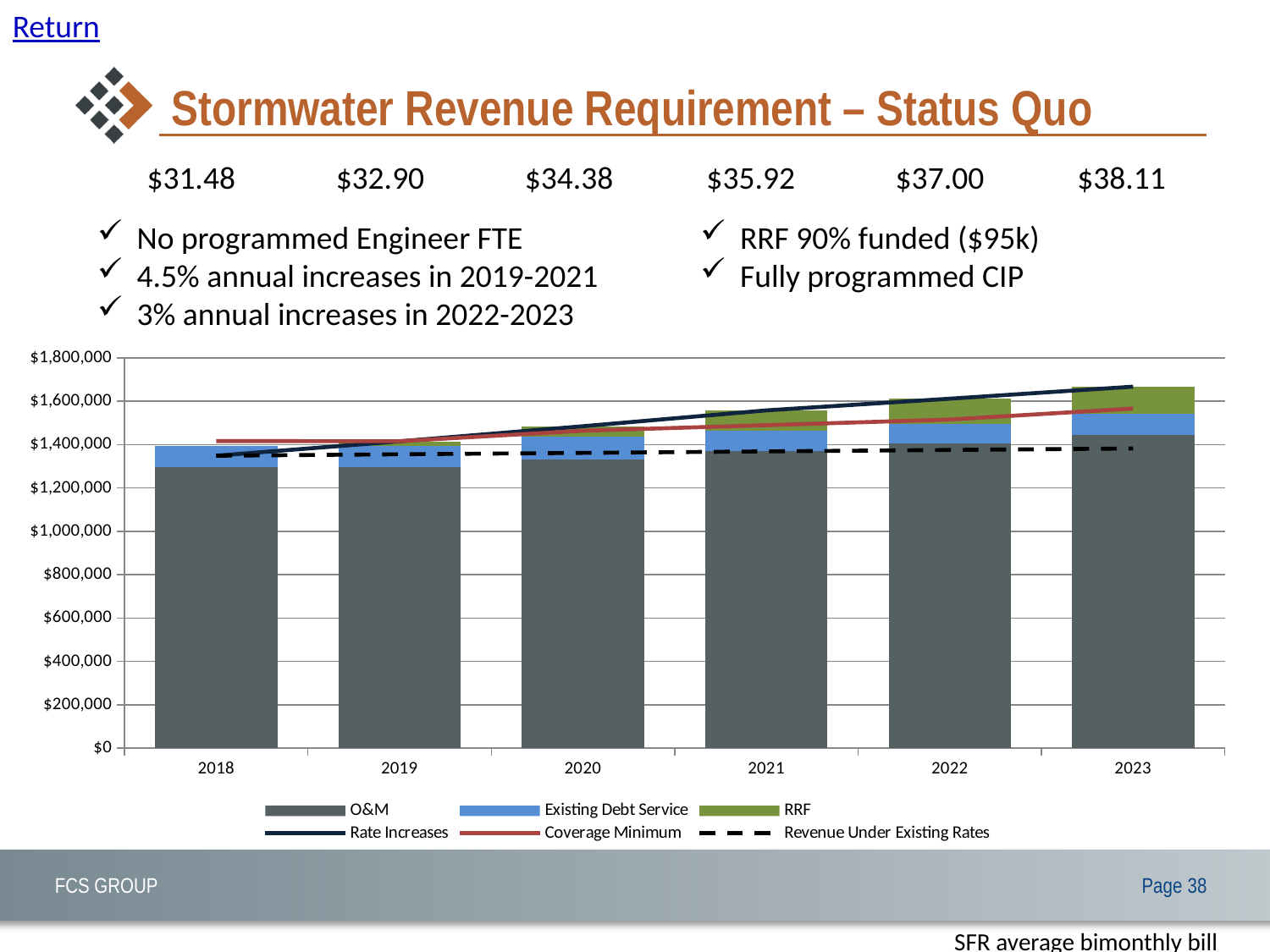
Which legend series is drawn as a dashed line? Revenue Under Existing Rates Is the total stacked bar for 2021 greater or less than $1,600,000? less Which is larger, the O&M value for 2023 or the O&M value for 2018? 2023 How many years are shown on the x axis of the chart? 6 Which year has the shortest stacked bar? 2018 Do the stacked bar totals rise or fall from 2018 to 2023? rise Which year has the tallest stacked bar? 2023 What kind of chart is shown on the slide? stacked bar chart with line series Is the O&M value for 2018 greater or less than $1,200,000? greater How many series does the chart legend list? 6 Is the total stacked bar for 2023 greater or less than $1,600,000? greater What colour represents RRF in the chart? green